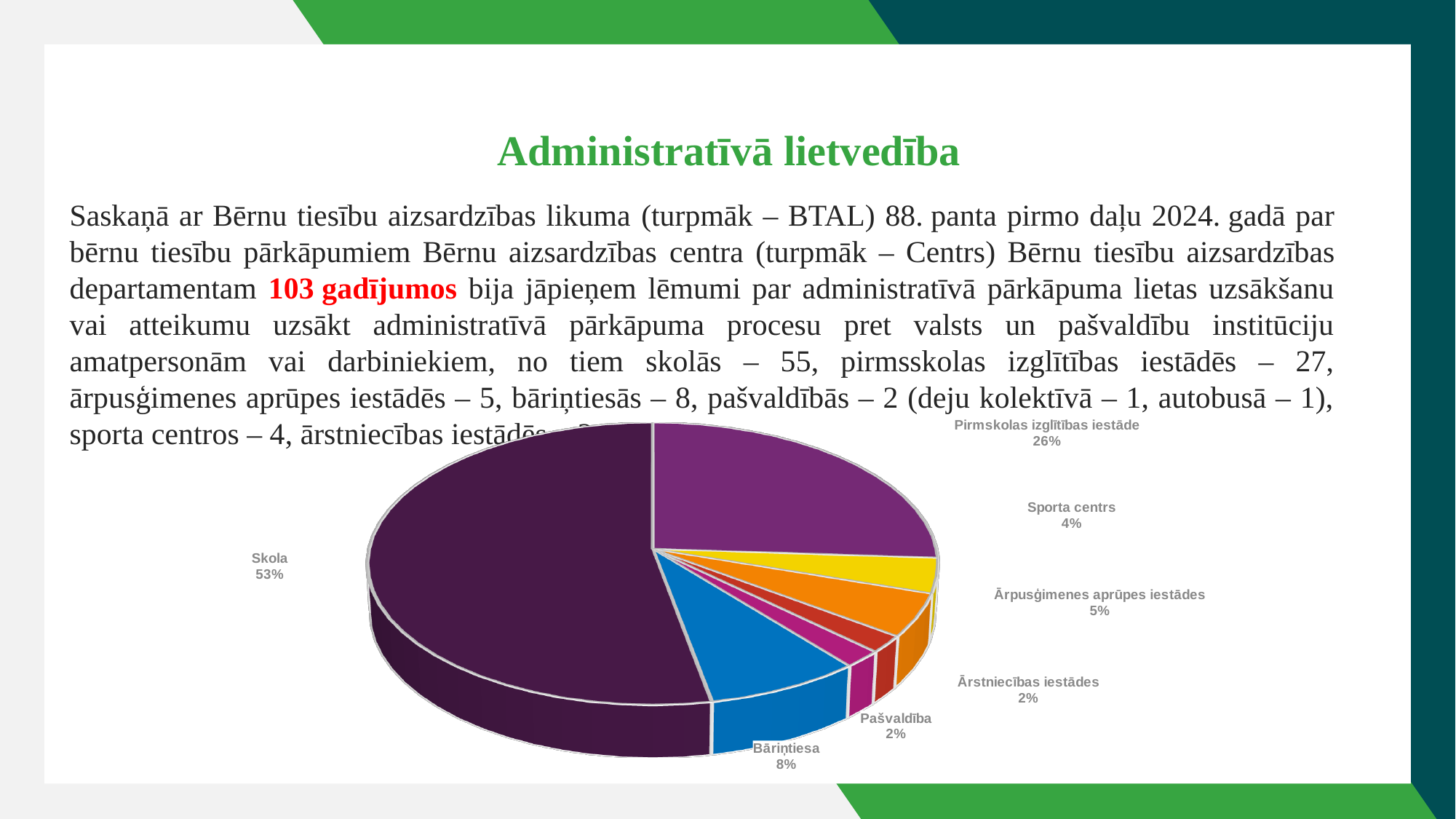
What is the value shown for Ārpusģimenes aprūpes iestādes? 5% Which category has the largest slice of the pie? Skola What is the difference in percentage points between Skola and Pirmskolas izglītības iestāde? 27 How many slices does the pie chart have? 7 What is the value shown for Sporta centrs? 4% Which is larger, Bāriņtiesa or Sporta centrs? Bāriņtiesa What kind of chart is shown on the slide? pie chart What is the value shown for Pirmskolas izglītības iestāde? 26% What share of the pie does Skola account for? 53% What is the difference in percentage points between Ārpusģimenes aprūpes iestādes and Pašvaldība? 3 What is the title of the slide containing the pie chart? Administratīvā lietvedība What is the value shown for Bāriņtiesa? 8%